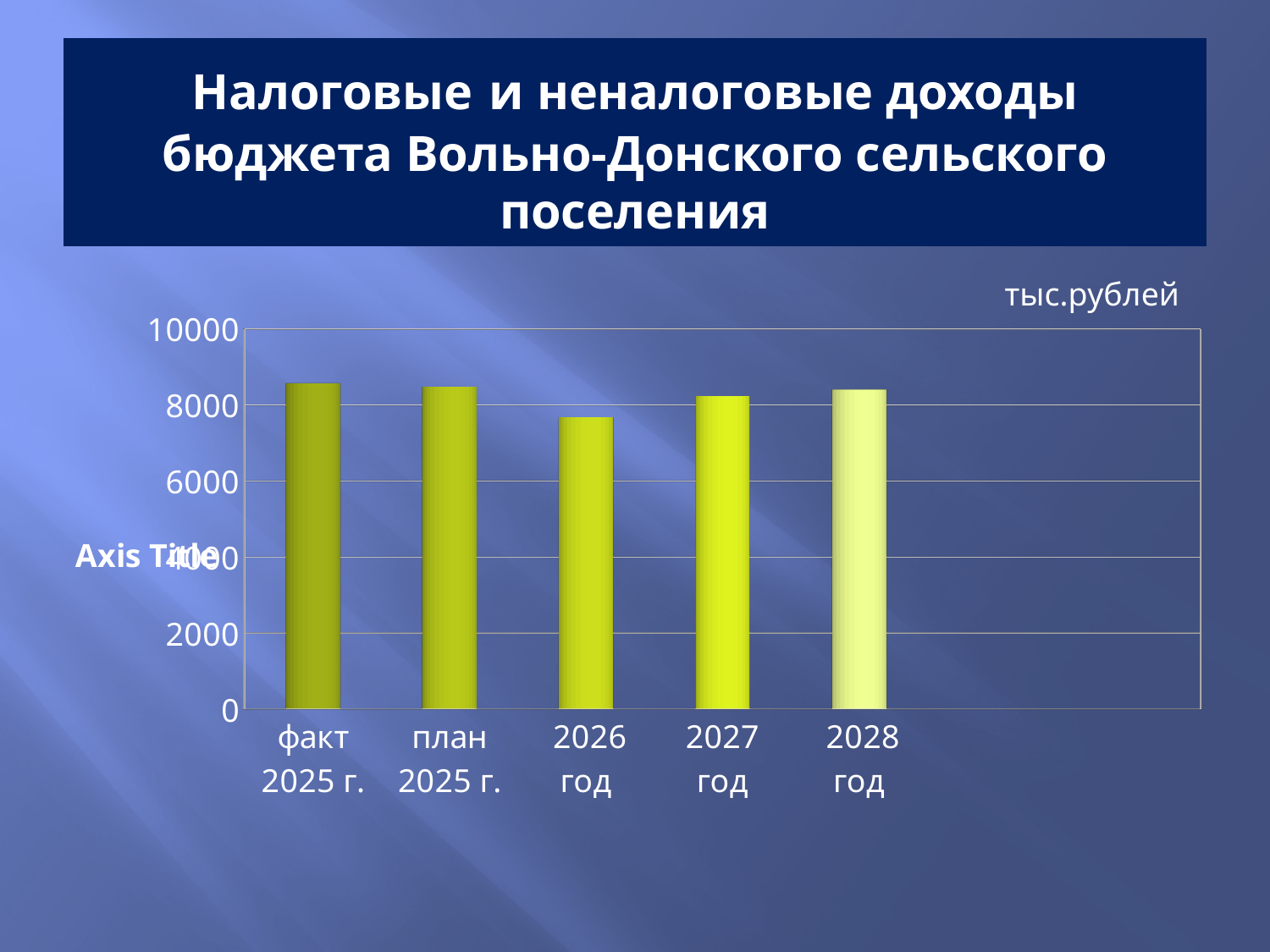
Which category has the lowest value on the chart? 2026 год What is the highest value shown on the vertical axis of the chart? 10000 How many categories (bars) are plotted on the chart? 5 Is the value for 2027 год greater or less than 6000? greater What unit of measurement is indicated above the chart? тыс.рублей What kind of chart is shown on the slide? bar chart Is the value for факт 2025 г. greater or less than 8000? greater Is the value for 2028 год greater or less than 8000? greater Which is larger: the value for план 2025 г. or the value for 2026 год? план 2025 г. Which is larger: the value for 2026 год or the value for 2027 год? 2027 год Which is larger: the value for факт 2025 г. or the value for 2026 год? факт 2025 г.